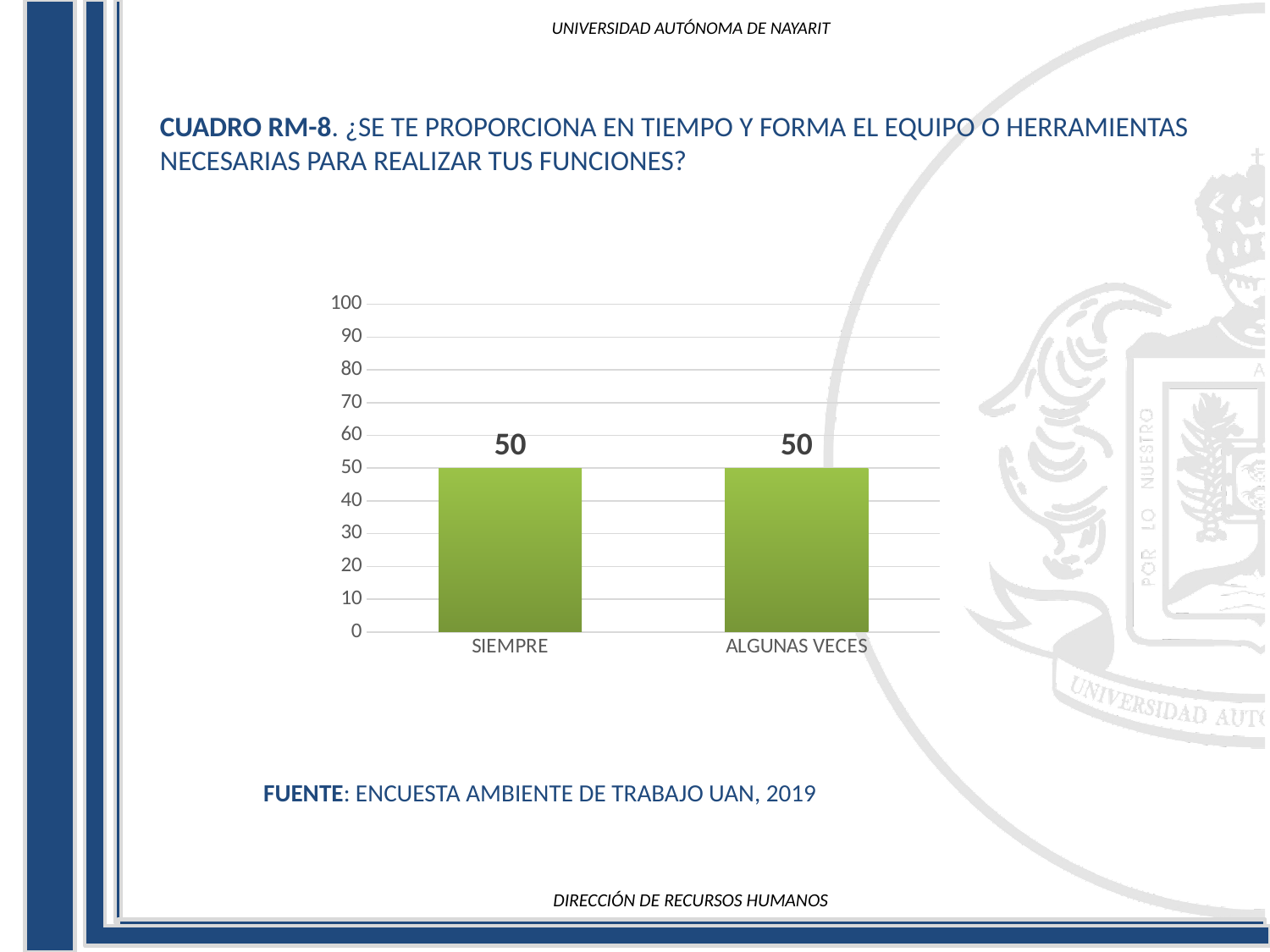
How many categories are shown on the x axis? 2 What is the total of the values for SIEMPRE and ALGUNAS VECES? 100 What kind of chart is shown on the slide? bar chart Is the value for SIEMPRE greater or less than 80? less What is the value for SIEMPRE? 50 What is the difference between the values for SIEMPRE and ALGUNAS VECES? 0 What is the value for ALGUNAS VECES? 50 What is the highest value shown on the y axis? 100 What colour are the bars in the chart? green Is the value for ALGUNAS VECES greater or less than 20? greater